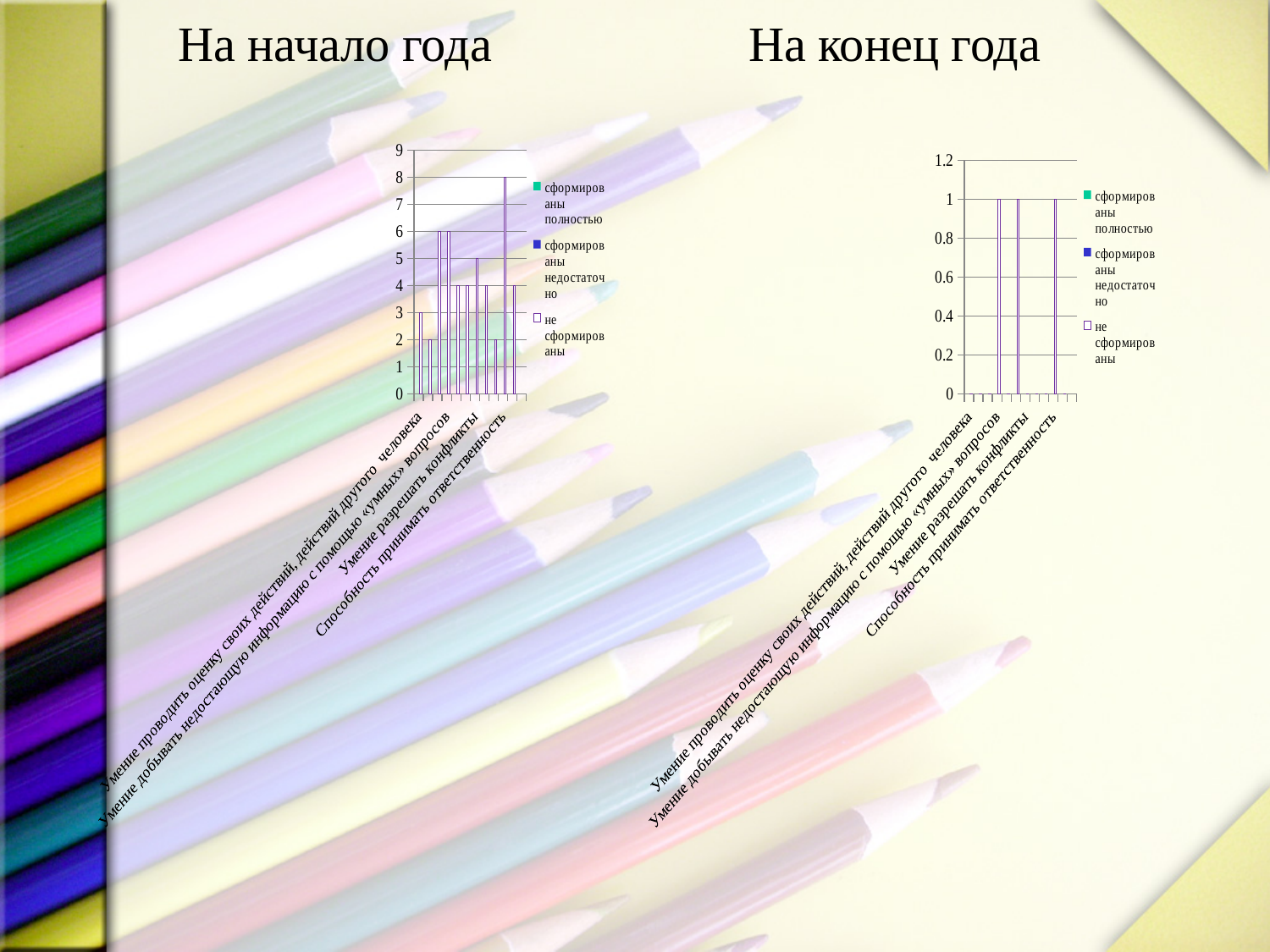
In the "На начало года" chart, what is the highest value shown on the y axis? 9 In the "На конец года" chart, are the tallest bars greater or less than 1.2? less How many series does the legend of the "На начало года" chart list? 3 In the "На начало года" chart, what value does the tallest bar reach? 8 What type of chart is shown under the title "На начало года"? bar chart In the "На конец года" chart, what value do the tallest bars reach? 1 In the "На конец года" chart, what is the highest value shown on the y axis? 1.2 How many series does the legend of the "На конец года" chart list? 3 In the "На начало года" chart, is the tallest bar greater or less than 6? greater What type of chart is shown under the title "На конец года"? bar chart